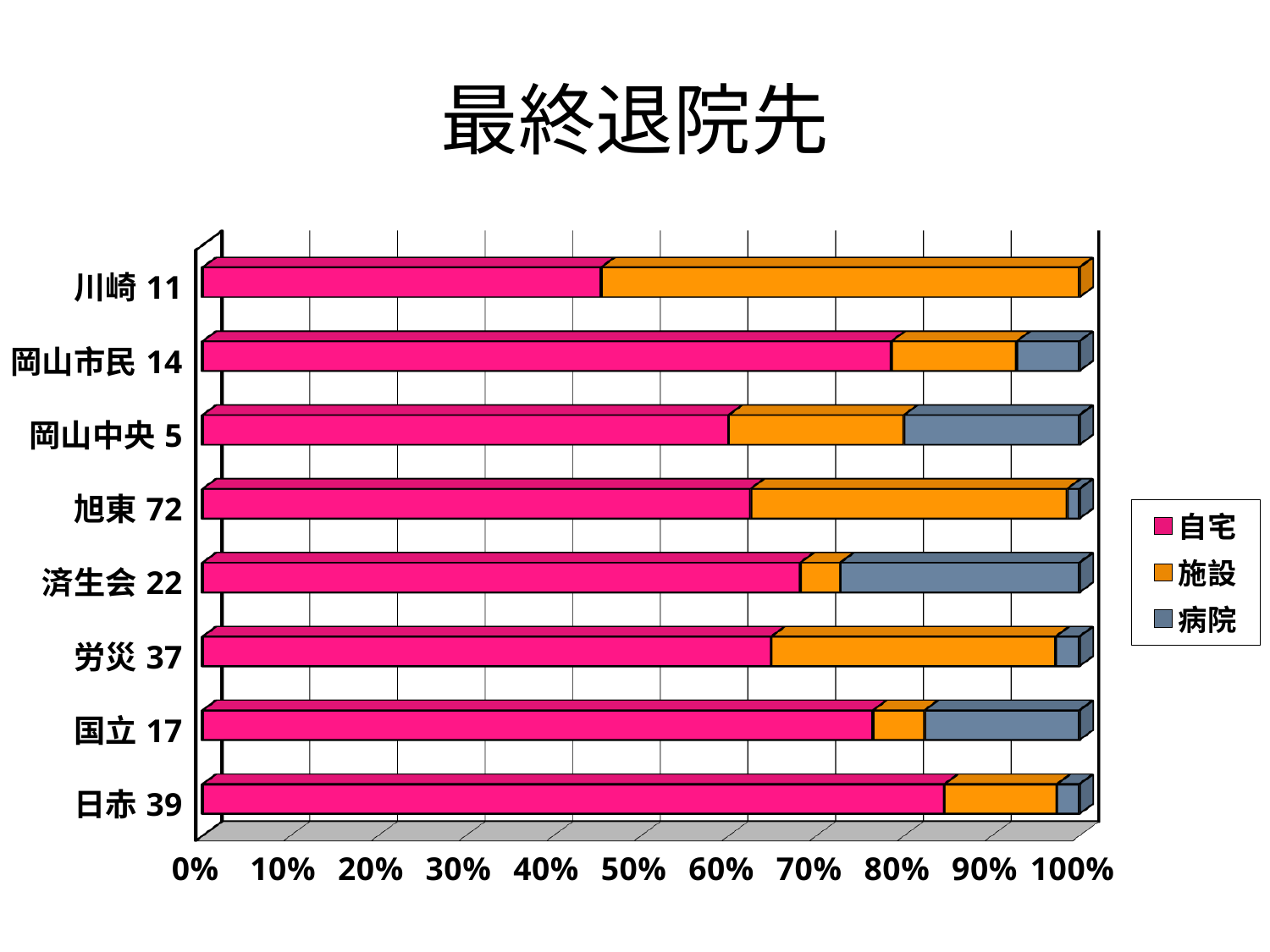
How many series does the legend list? 3 Which has the larger 自宅 share, 川崎 11 or 岡山市民 14? 岡山市民 14 Which hospital has the smallest 自宅 share? 川崎 11 Is the 自宅 share for 川崎 11 greater or less than 50%? less What kind of chart is shown on the slide? Stacked bar chart Which hospital's bar has no 病院 segment? 川崎 11 Which hospital has the largest 自宅 share? 日赤 39 Is the 自宅 share for 岡山市民 14 greater or less than 70%? greater Is the 自宅 share for 日赤 39 greater or less than 80%? greater Which has the larger 病院 share, 済生会 22 or 旭東 72? 済生会 22 How many hospitals (categories) are plotted on the chart? 8 What is the title of the chart? 最終退院先